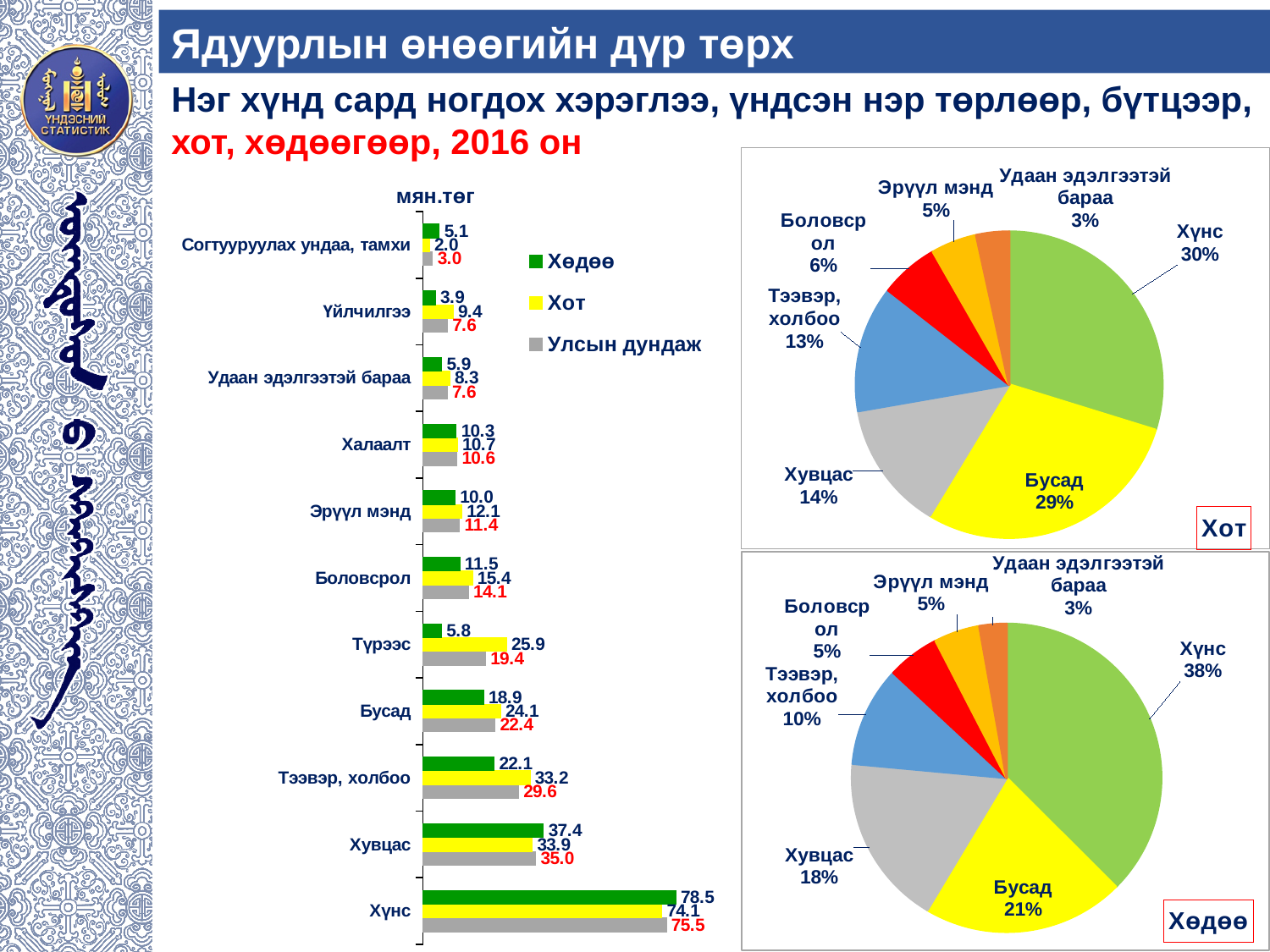
In the bar chart on the left, which category has the lowest Хот value? Согтууруулах ундаа, тамхи In the bar chart on the left, what is the Хөдөө value for Хүнс? 78.5 In the bar chart on the left, what is the Улсын дундаж value for Тээвэр, холбоо? 29.6 In the Хөдөө pie chart, which category has the largest share? Хүнс In the Хот pie chart, what share does Бусад have? 29% How many series does the legend of the bar chart on the left list? 3 In the bar chart on the left, what is the difference between the Хот and Хөдөө values for Түрээс? 20.1 What kind of chart is the chart in the bottom right labelled Хөдөө? Pie chart In the bar chart on the left, which is larger for Хувцас: the Хөдөө value or the Хот value? Хөдөө How many categories are shown in the bar chart on the left? 11 In the bar chart on the left, what is the Хот value for Түрээс? 25.9 In the bar chart on the left, which category has the highest Хот value? Хүнс